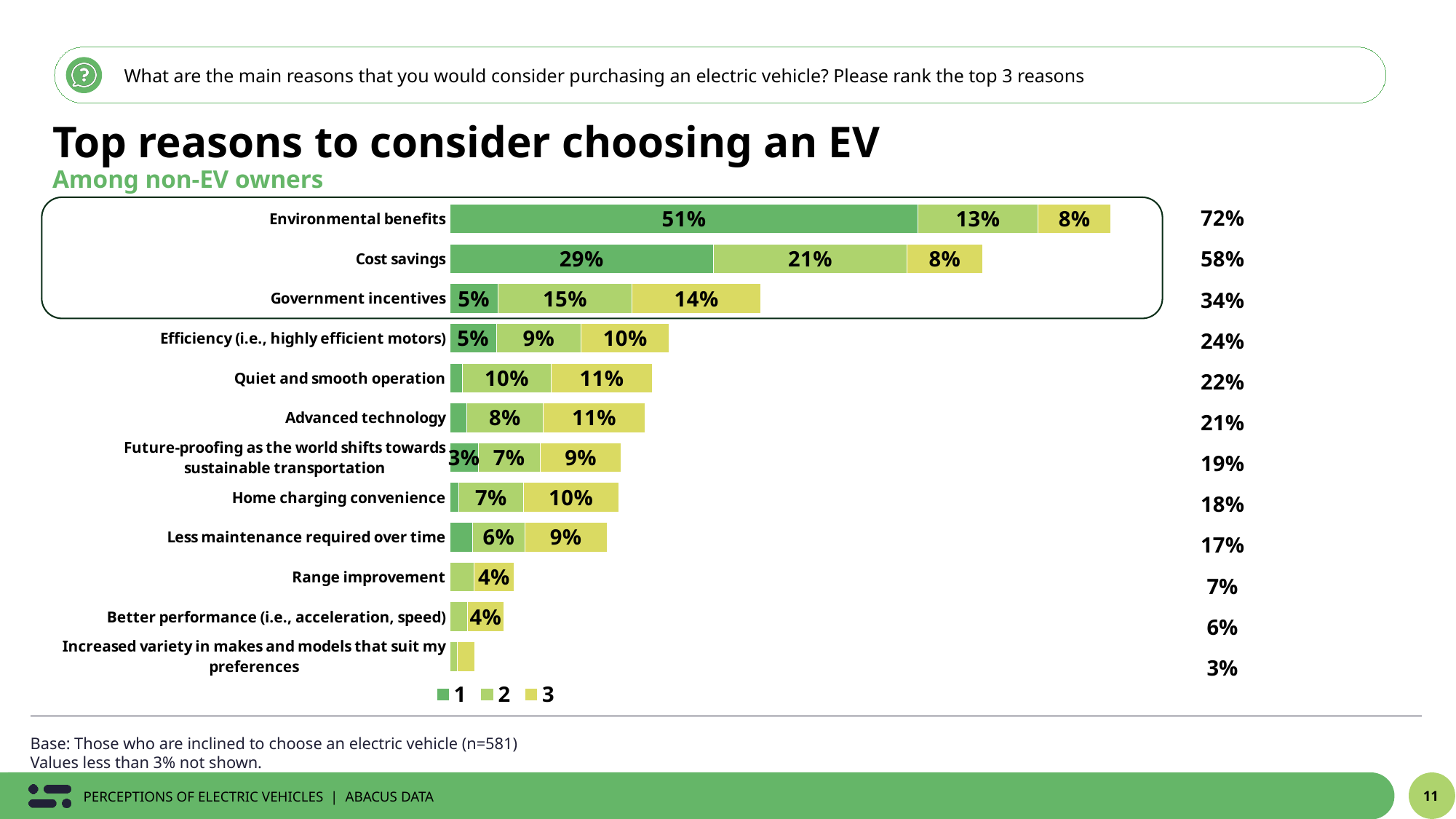
What type of chart is shown on the slide? Stacked bar chart What percentage of respondents ranked Environmental benefits as their number 1 reason? 51% Which reason has the lowest total percentage? Increased variety in makes and models that suit my preferences What is the total of the stacked bar for Cost savings? 58% Which reason has the highest total percentage? Environmental benefits What is the rank 3 value for Government incentives? 14% How many reasons (categories) are listed in the chart? 12 How many series does the legend list? 3 What is the total percentage shown for Quiet and smooth operation? 22% What is the rank 2 value for Cost savings? 21% Which has a larger total: Government incentives or Efficiency (i.e., highly efficient motors)? Government incentives What is the difference between the total for Environmental benefits and the total for Cost savings? 14%